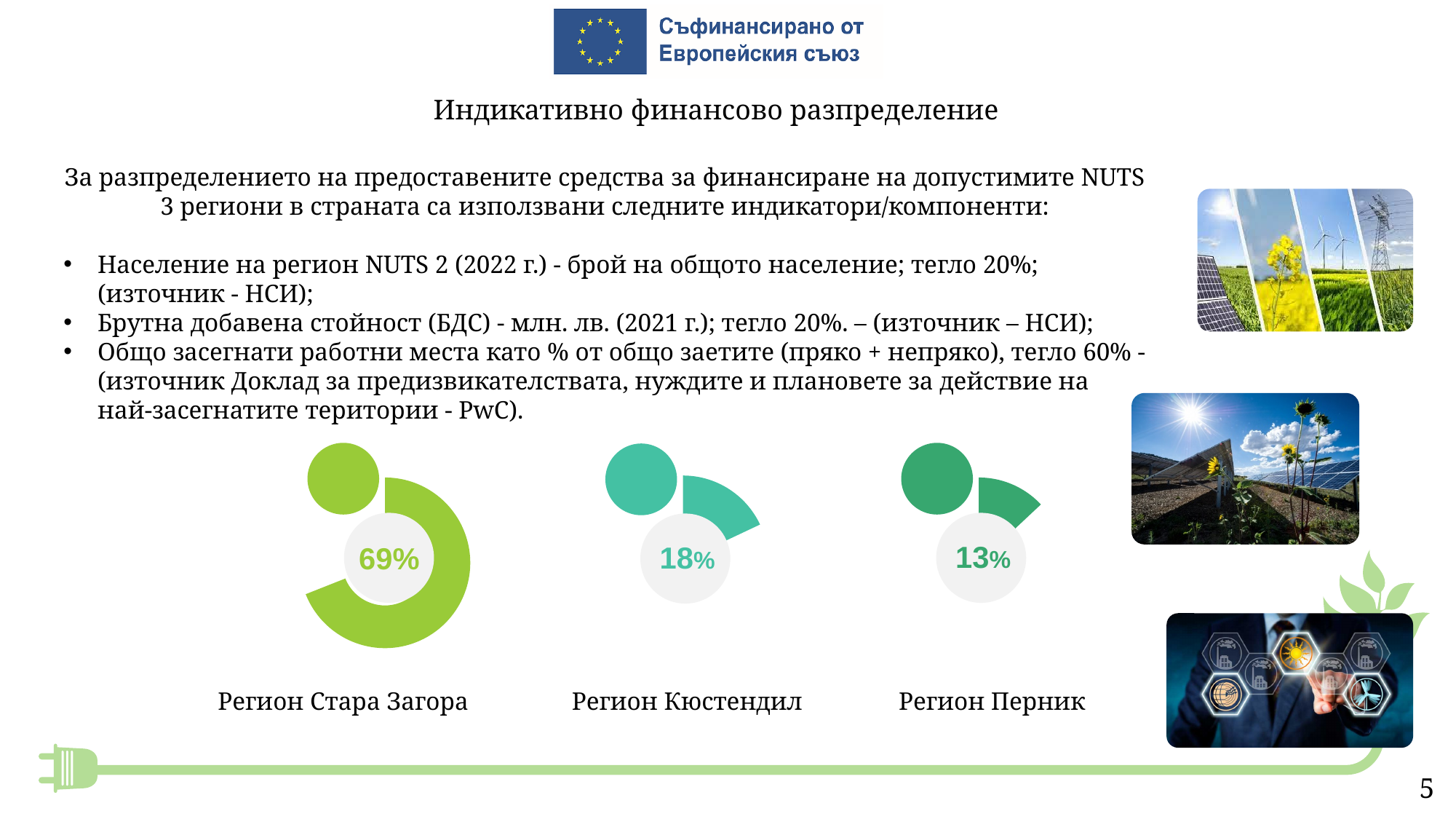
What kind of charts are used to show the regional percentages? Donut (ring) charts What is the title of the slide containing the regional percentage charts? Индикативно финансово разпределение What percentage is shown for Регион Перник? 13% Which region has the highest share in the indicative financial distribution? Регион Стара Загора What percentage is shown for Регион Стара Загора? 69% What is the difference in percentage points between Регион Кюстендил and Регион Перник? 5 Which has a larger share, Регион Кюстендил or Регион Перник? Регион Кюстендил What is the combined percentage of the three regions shown? 100% What is the difference in percentage points between Регион Стара Загора and Регион Кюстендил? 51 How many regions are shown in the charts at the bottom of the slide? 3 Which region has the lowest share in the indicative financial distribution? Регион Перник What percentage is shown for Регион Кюстендил? 18%